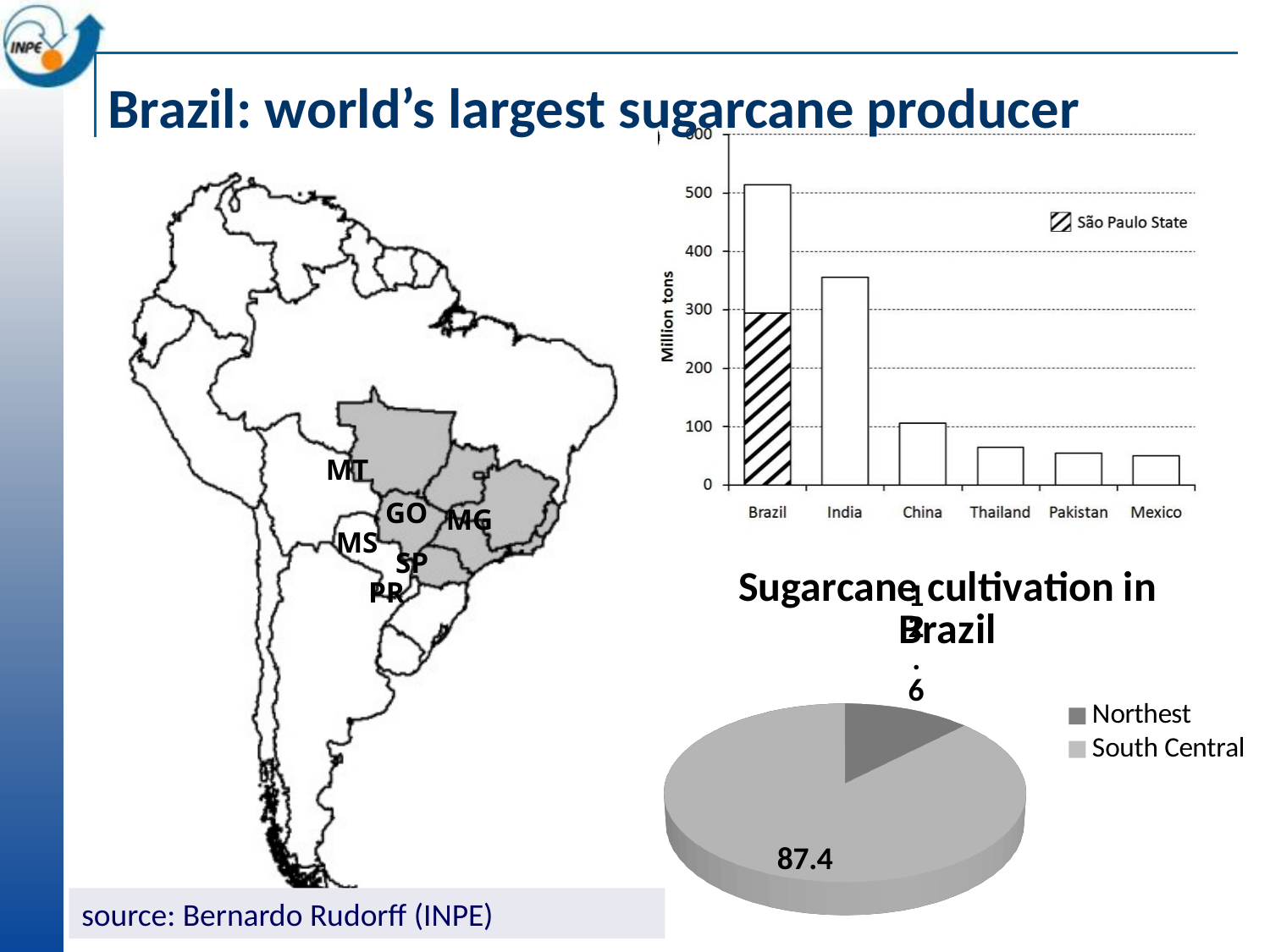
In the bar chart at the top right, which is larger, the value for India or the value for China? India What kind of chart is 'Sugarcane cultivation in Brazil'? pie chart In the bar chart at the top right, is the value for India greater or less than 400? less What kind of chart is the chart at the top right of the slide showing production by country? bar chart In the bar chart at the top right, what is the label on the y axis? Million tons In the bar chart at the top right, is the value for Thailand greater or less than 100? less In the bar chart at the top right, how many countries are shown on the x axis? 6 In the bar chart at the top right, do the values rise or fall from Brazil to Mexico along the x axis? fall In the 'Sugarcane cultivation in Brazil' chart, how many entries does the legend list? 2 In the 'Sugarcane cultivation in Brazil' chart, what is the value shown for South Central? 87.4 In the bar chart at the top right, which country has the highest value? Brazil In the bar chart at the top right, is the value for Brazil greater or less than 500? greater